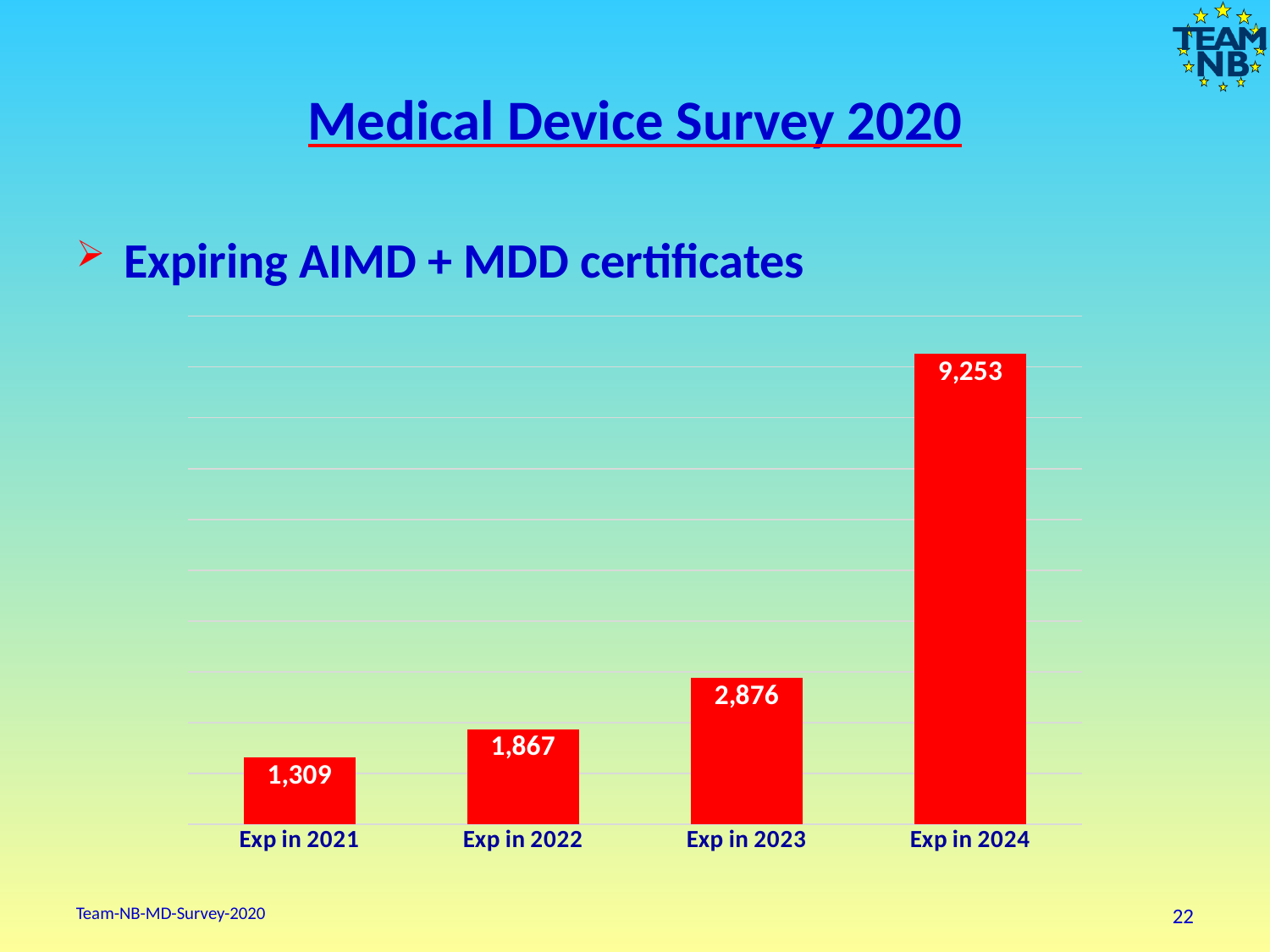
Which category has the highest value? Exp in 2024 What is the value for Exp in 2024? 9,253 What kind of chart is shown on the slide? Bar chart What is the value for Exp in 2023? 2,876 What is the difference between the values for Exp in 2022 and Exp in 2021? 558 Which category has the lowest value? Exp in 2021 What is the value for Exp in 2022? 1,867 Do the values rise or fall from Exp in 2021 to Exp in 2024? Rise What is the difference between the values for Exp in 2024 and Exp in 2023? 6,377 How many categories are shown in the chart? 4 Which is larger, the value for Exp in 2023 or the value for Exp in 2022? Exp in 2023 What is the value for Exp in 2021? 1,309